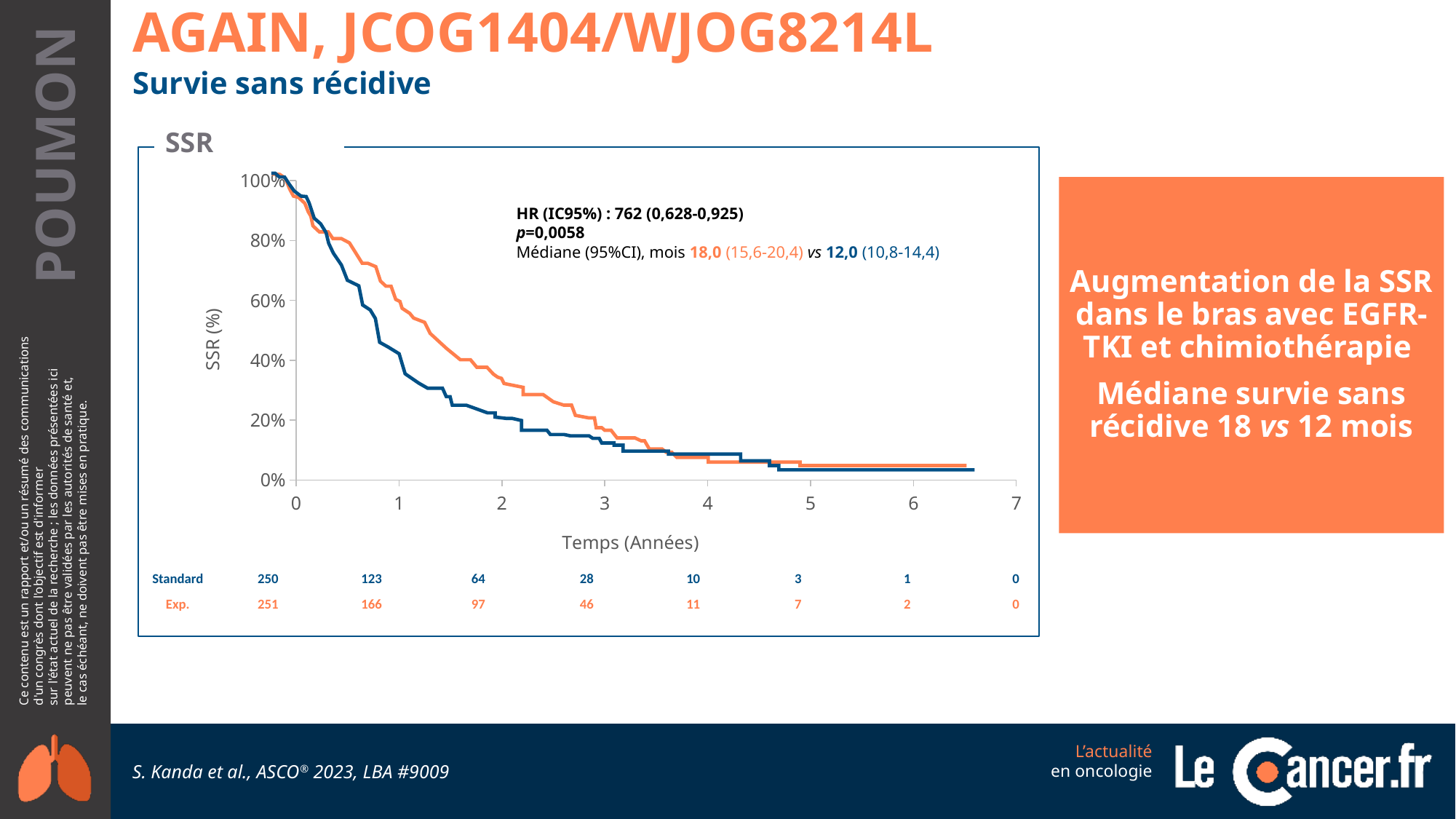
Is the SSR value of the Exp. curve at 1 year greater or less than 40%? greater How many Standard-arm patients were at risk at 3 years? 28 What kind of chart is shown on the slide? line chart What is the p-value printed on the chart? p=0,0058 What is the median recurrence-free survival (in months) reported for the Exp. arm? 18,0 According to the at-risk table, how many patients were in the Exp. arm at 1 year? 166 What is the difference in the number of patients at risk at 1 year between the Exp. arm (166) and the Standard arm (123)? 43 At 2 years, which arm has more patients at risk, Standard or Exp.? Exp. According to the at-risk table, how many patients were in the Standard arm at time 0? 250 Do the survival curves rise or fall as time increases along the x axis? fall How many series (treatment arms) are plotted in the SSR chart? 2 What is the median recurrence-free survival (in months) reported for the Standard arm? 12,0